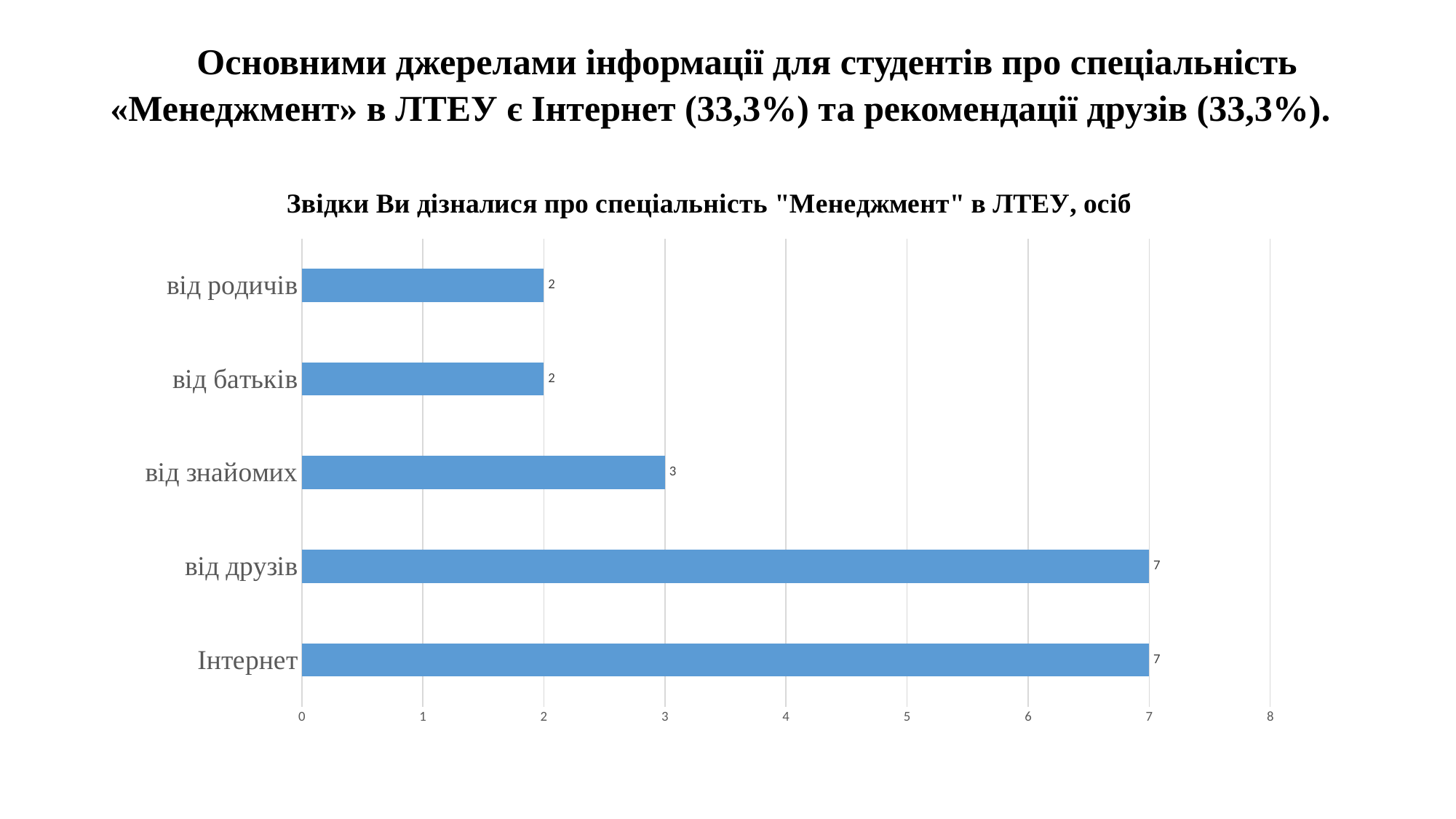
What is the total of the values for Інтернет and від друзів? 14 Which category has the lowest value, від знайомих or від батьків? від батьків Is the value for Інтернет greater or less than 5? greater Which is larger, the value for від друзів or the value for від родичів? від друзів What is the difference between the values for від друзів and від знайомих? 4 What is the value for від батьків? 2 What kind of chart is shown on the slide? bar chart What is the value for Інтернет? 7 What is the value for від родичів? 2 What is the value for від знайомих? 3 What is the title of the chart? Звідки Ви дізналися про спеціальність "Менеджмент" в ЛТЕУ, осіб How many categories are shown in the chart? 5